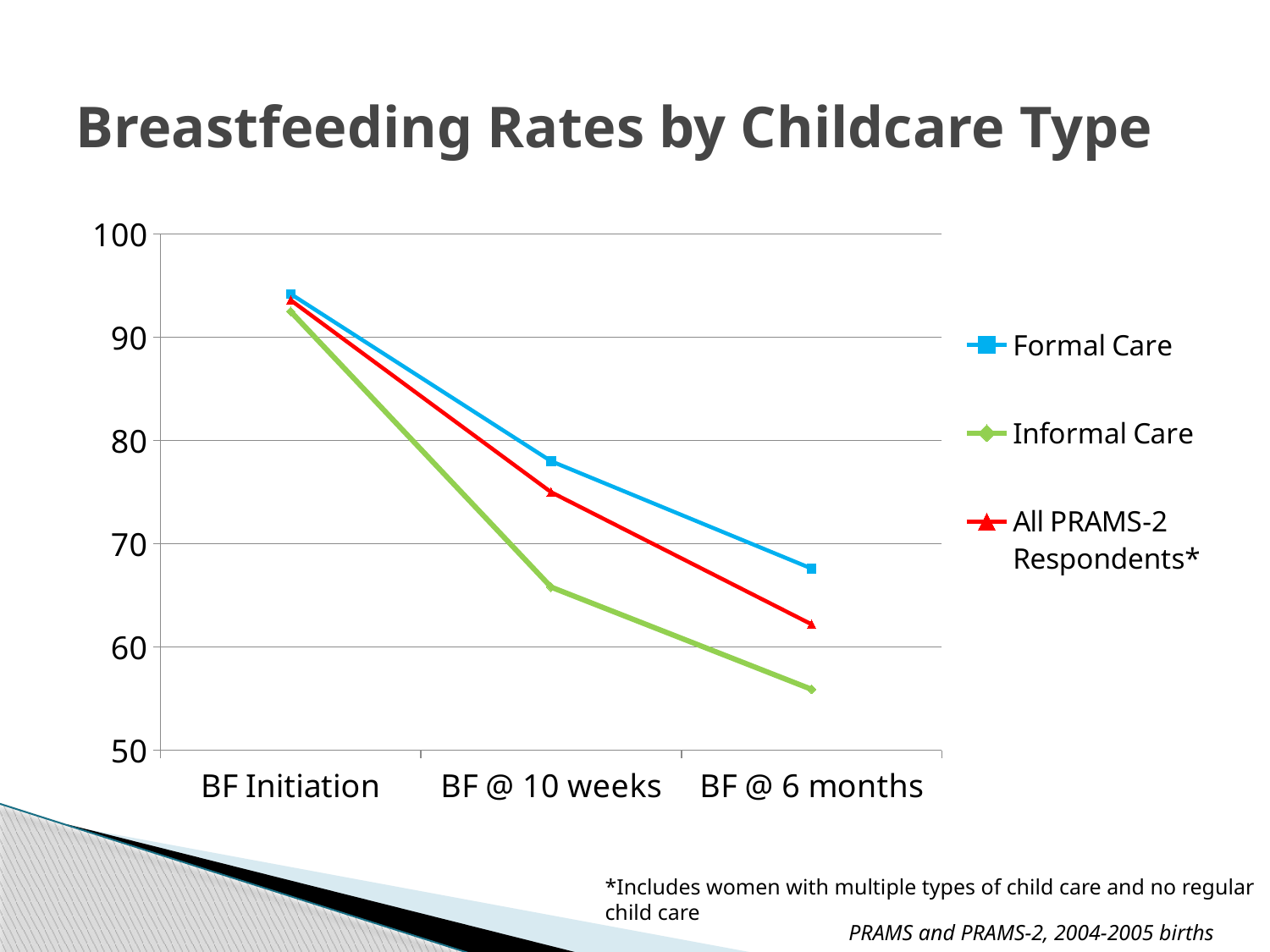
What is the title of the chart? Breastfeeding Rates by Childcare Type Is the value for Formal Care at BF @ 10 weeks greater or less than 70? greater Which series has the lowest value at BF @ 10 weeks? Informal Care Do the values for Informal Care rise or fall from BF Initiation to BF @ 6 months? fall Which series has the highest value at BF @ 6 months? Formal Care Is the value for Formal Care at BF @ 6 months greater or less than 70? less What kind of chart is shown on the slide? line chart Is the value for Informal Care at BF @ 6 months greater or less than 60? less Which series has the lowest value at BF @ 6 months? Informal Care How many categories are shown on the x axis? 3 How many series does the legend list? 3 At BF @ 10 weeks, which is larger: Formal Care or Informal Care? Formal Care